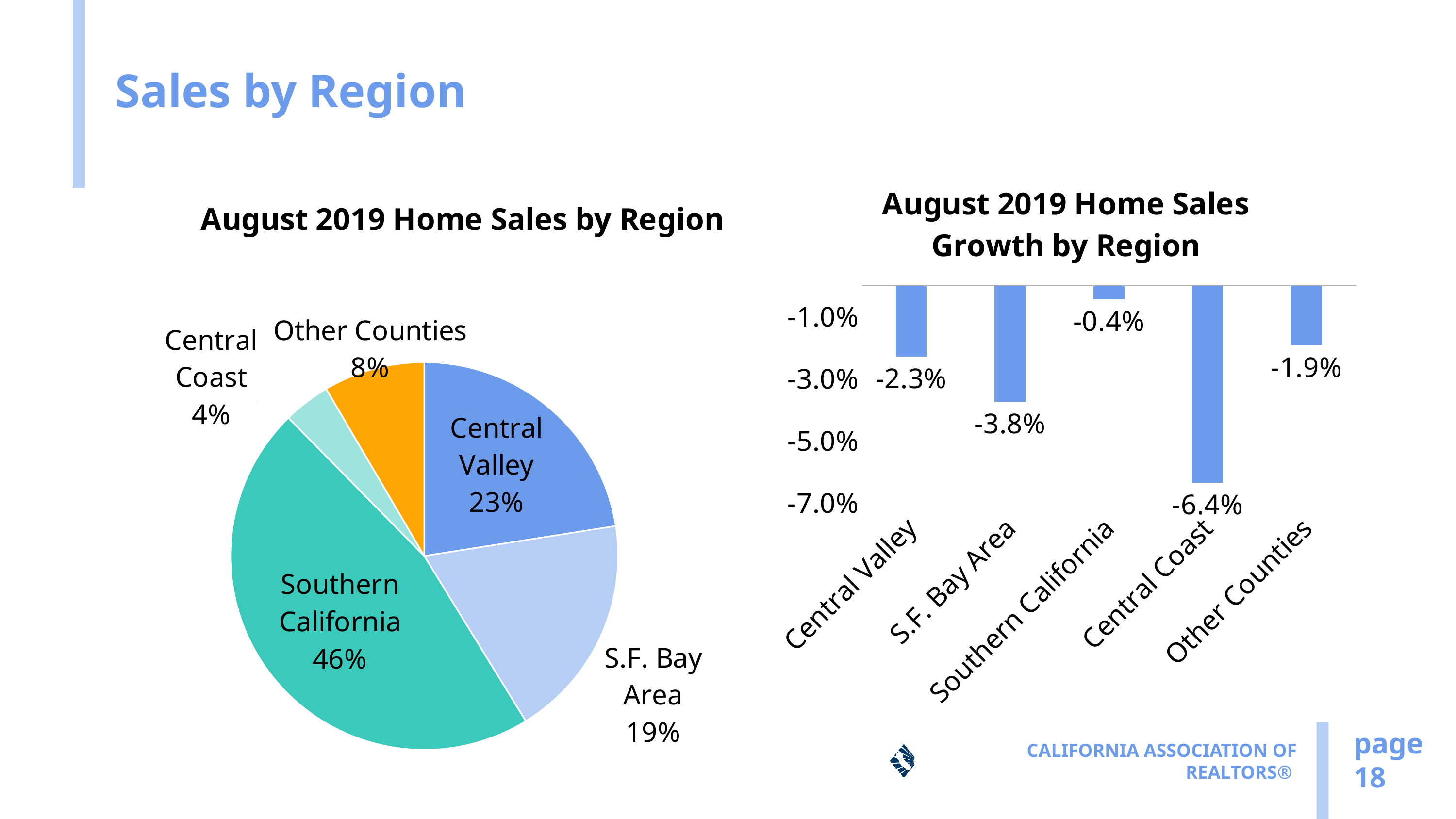
What kind of chart is 'August 2019 Home Sales Growth by Region'? bar chart In the 'August 2019 Home Sales by Region' pie chart, what share does Southern California have? 46% In the 'August 2019 Home Sales by Region' pie chart, which region has the largest share? Southern California In the 'August 2019 Home Sales by Region' pie chart, how many slices are there? 5 In the 'August 2019 Home Sales by Region' pie chart, what is the difference between the Central Valley share and the S.F. Bay Area share? 4% In the 'August 2019 Home Sales Growth by Region' chart, which is larger, the value for Central Valley or the value for Other Counties? Other Counties In the 'August 2019 Home Sales Growth by Region' chart, which region has the largest decline? Central Coast In the 'August 2019 Home Sales Growth by Region' chart, which region has the smallest decline? Southern California In the 'August 2019 Home Sales Growth by Region' chart, what is the value for Central Coast? -6.4% In the 'August 2019 Home Sales by Region' pie chart, what share does Central Valley have? 23% In the 'August 2019 Home Sales by Region' pie chart, which region has the smallest share? Central Coast In the 'August 2019 Home Sales Growth by Region' chart, what is the value for S.F. Bay Area? -3.8%